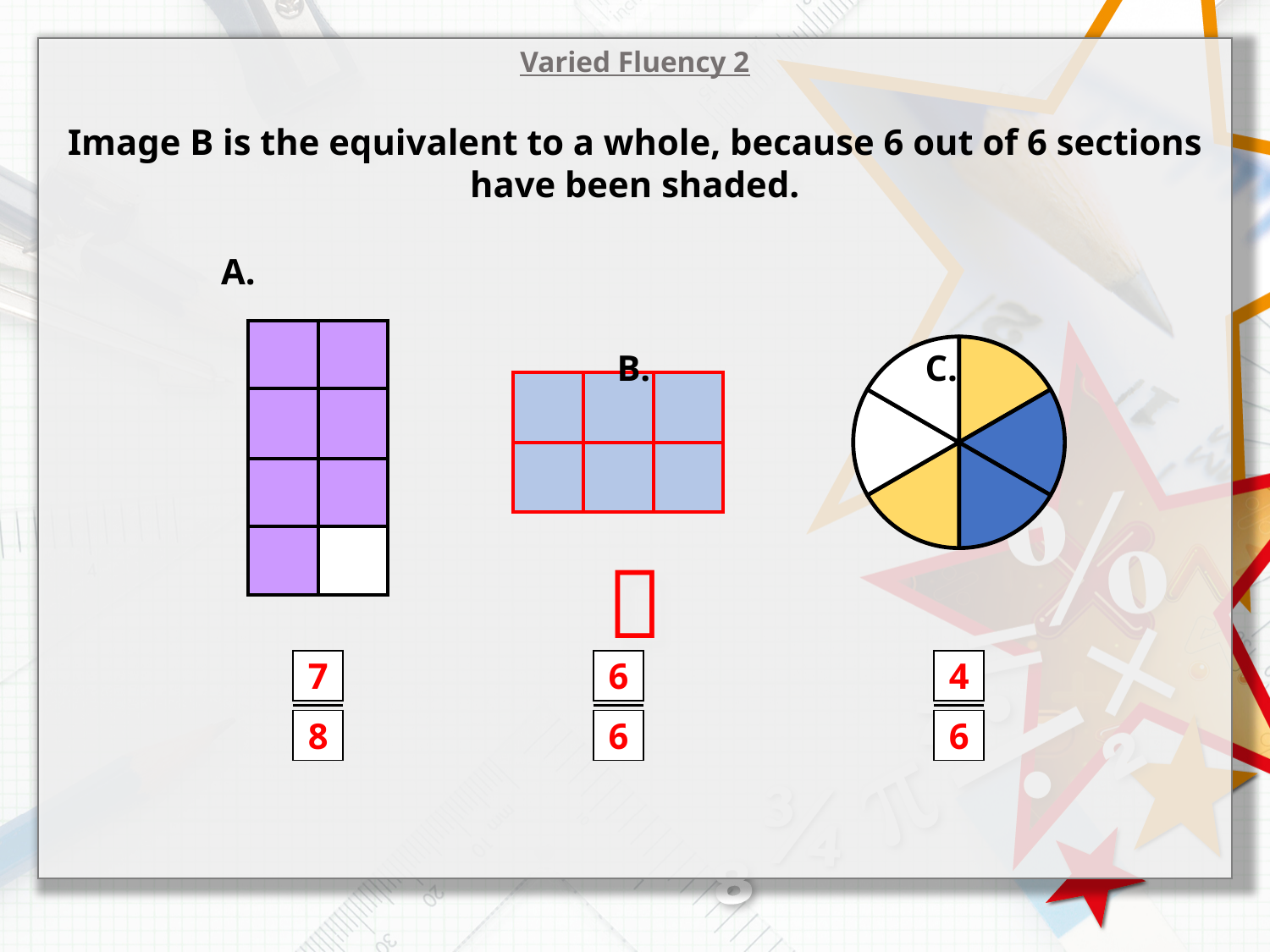
Which image is described as equivalent to a whole? B What fraction is printed below Image C? 4/6 How many sections in Image C are shaded yellow? 2 What is the title of the slide? Varied Fluency 2 Which image has the most sections in total? A How many sections does the grid in Image A have? 8 How many sections in Image A are shaded? 7 What fraction is printed below Image A? 7/8 What fraction is printed below Image B? 6/6